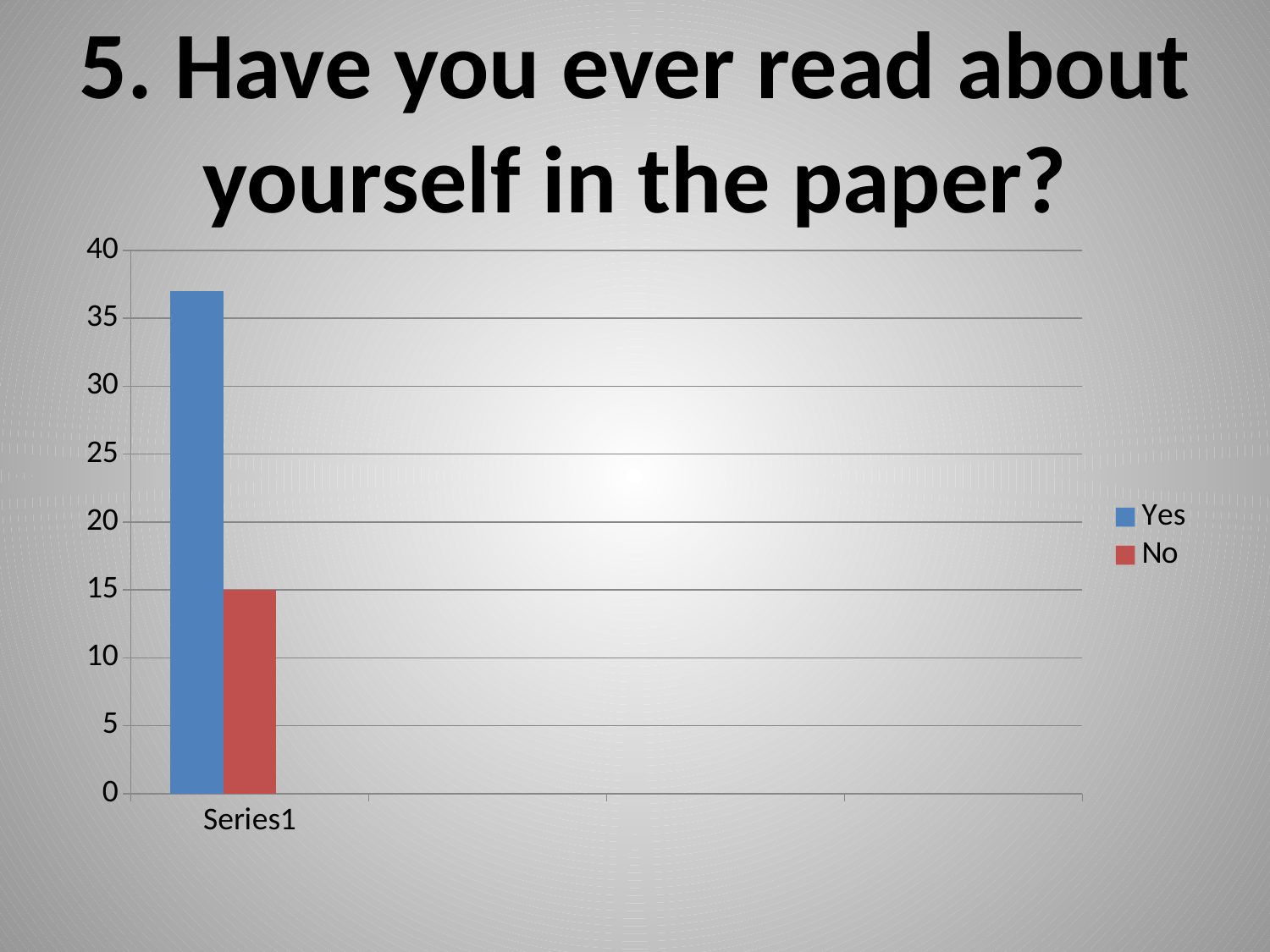
Is the value for Yes greater or less than 40? less Is the value for Yes greater or less than 35? greater What kind of chart is shown on the slide? bar chart What is the maximum value shown on the vertical axis? 40 How many series does the legend list? 2 Is the value for No greater or less than 20? less Which series has the taller bar, Yes or No? Yes What is the value of the No bar? 15 Which series has the highest value? Yes What is the category label shown on the x axis? Series1 Which series has the lowest value? No What are the two series named in the legend? Yes and No